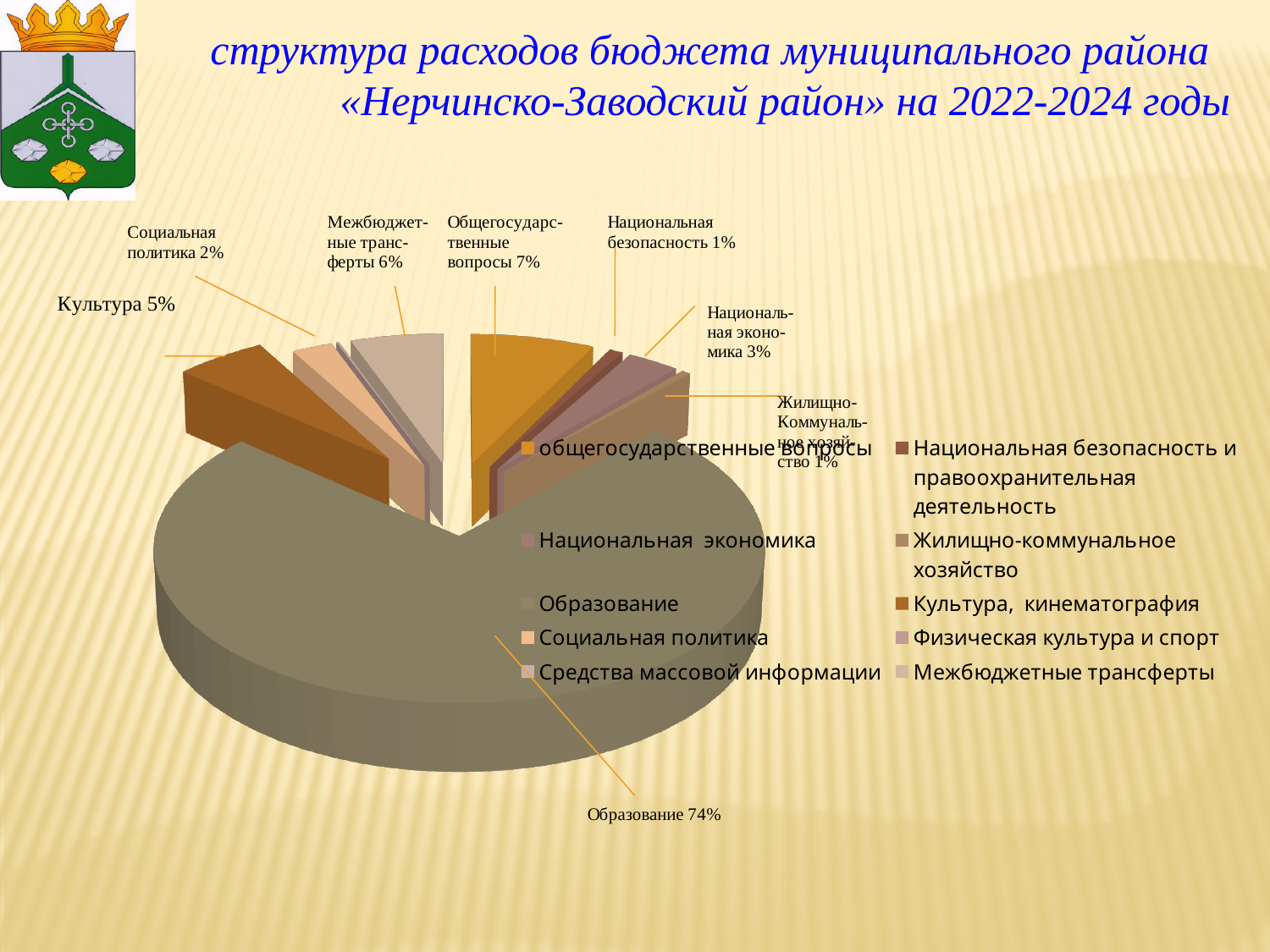
How many entries does the legend list? 10 What percentage is shown for Культура? 5% Which category has the largest share of the pie? Образование What percentage is shown for Социальная политика? 2% What is the difference in percentage points between Культура and Социальная политика? 3 What percentage is shown for Межбюджетные трансферты? 6% What kind of chart is shown on the slide? Pie chart What percentage is shown for Национальная экономика? 3% What percentage is shown for Общегосударственные вопросы? 7% What share of the pie does Образование have? 74% What is the difference in percentage points between Образование and Общегосударственные вопросы? 67 Which is larger, Общегосударственные вопросы or Межбюджетные трансферты? Общегосударственные вопросы